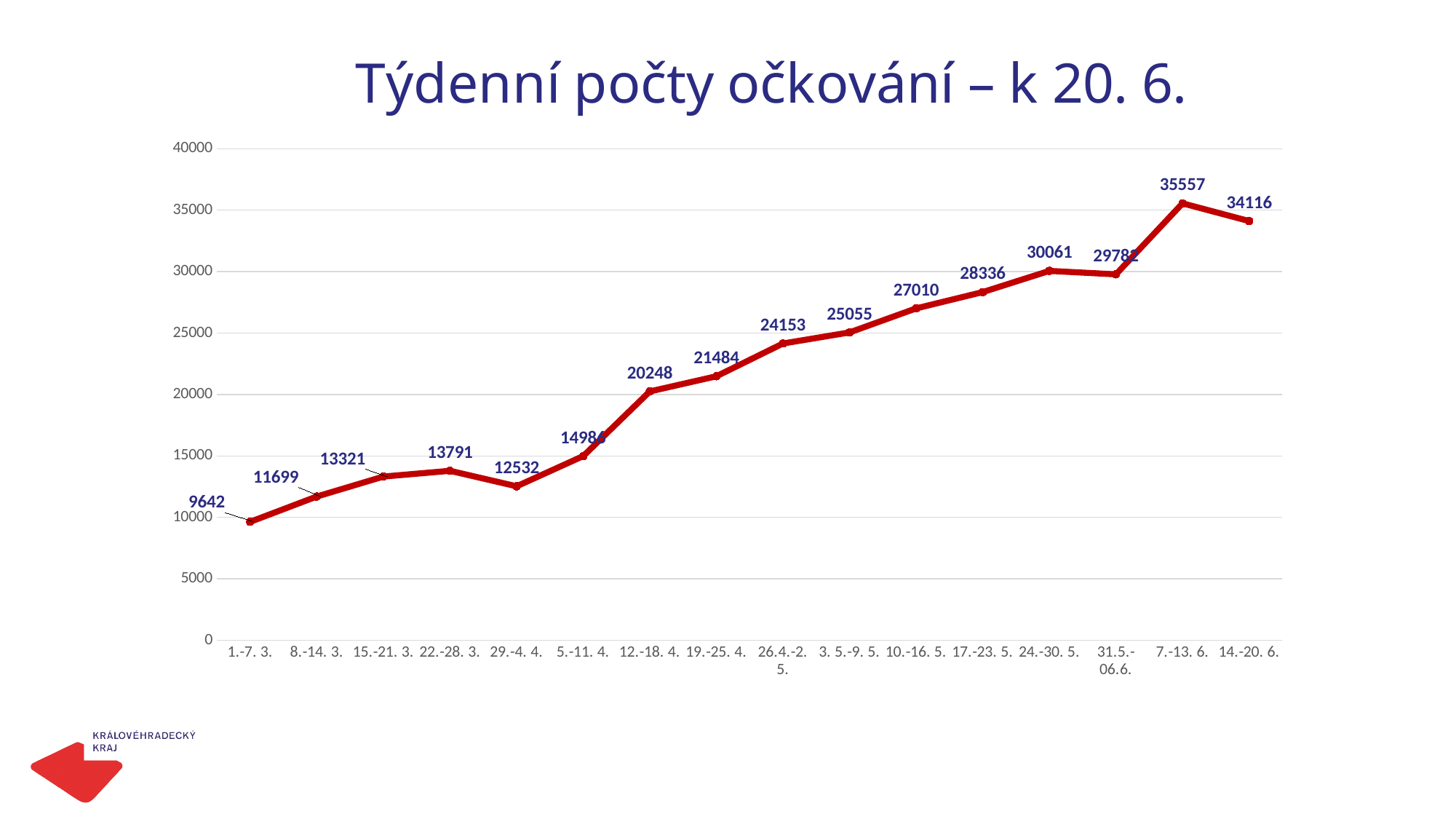
What is the value for the week 14.-20. 6.? 34116 What is the title of the chart? Týdenní počty očkování – k 20. 6. Which week has the lowest value? 1.-7. 3. Is the value for 24.-30. 5. greater or less than 30000? greater What is the value for the week 7.-13. 6.? 35557 How many weeks are plotted on the chart? 16 What type of chart is shown on the slide? line chart Which is larger, the value for 22.-28. 3. or the value for 29.-4. 4.? 22.-28. 3. What is the difference between the values for 7.-13. 6. and 14.-20. 6.? 1441 What is the value for the week 1.-7. 3.? 9642 What is the value for the week 12.-18. 4.? 20248 Which week has the highest value? 7.-13. 6.